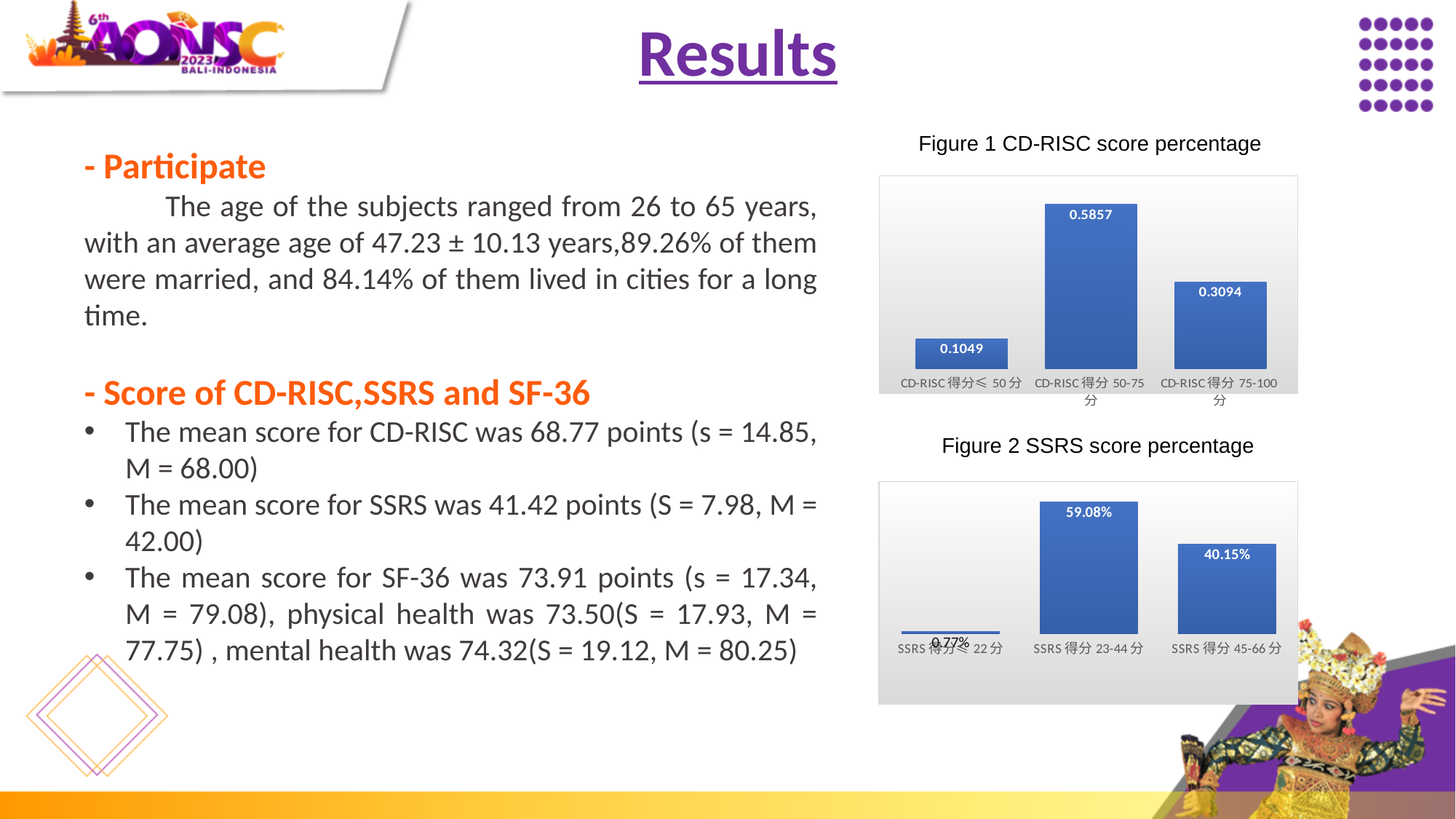
In the Figure 1 CD-RISC score percentage chart, which category has the lowest value? CD-RISC 得分 ≤ 50 分 In the Figure 1 CD-RISC score percentage chart, what is the value for the CD-RISC 得分 50-75 分 category? 0.5857 In the Figure 1 CD-RISC score percentage chart, what is the value for the CD-RISC 得分 ≤ 50 分 category? 0.1049 In the Figure 1 CD-RISC score percentage chart, what is the difference between the CD-RISC 得分 50-75 分 value and the CD-RISC 得分 75-100 分 value? 0.2763 In the Figure 2 SSRS score percentage chart, what is the value for the SSRS 得分 ≤ 22 分 category? 0.77% In the Figure 2 SSRS score percentage chart, which is larger: the value for SSRS 得分 23-44 分 or the value for SSRS 得分 45-66 分? SSRS 得分 23-44 分 What type of chart is Figure 2 SSRS score percentage? Bar chart What is the title of the upper chart on the slide? Figure 1 CD-RISC score percentage In the Figure 2 SSRS score percentage chart, what is the difference between the SSRS 得分 23-44 分 value and the SSRS 得分 45-66 分 value? 18.93% In the Figure 2 SSRS score percentage chart, what is the value for the SSRS 得分 23-44 分 category? 59.08% In the Figure 2 SSRS score percentage chart, which category has the highest value? SSRS 得分 23-44 分 In the Figure 1 CD-RISC score percentage chart, how many bars are plotted? 3